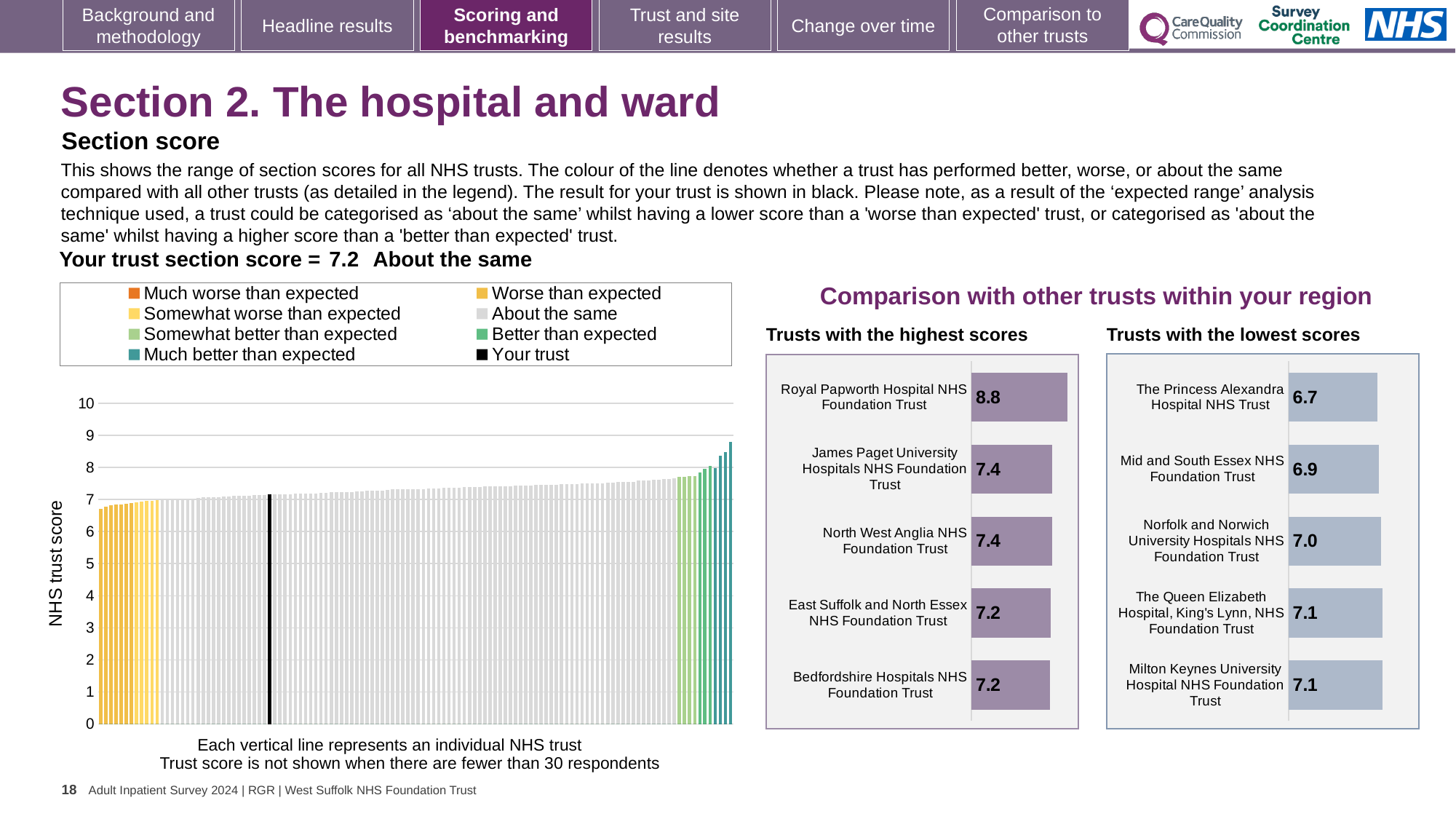
In the 'Trusts with the lowest scores' chart, which has the larger score: Mid and South Essex NHS Foundation Trust or Norfolk and Norwich University Hospitals NHS Foundation Trust? Norfolk and Norwich University Hospitals NHS Foundation Trust In the 'Trusts with the highest scores' chart, which trust has the highest score? Royal Papworth Hospital NHS Foundation Trust In the 'Trusts with the highest scores' chart, what is the score for Royal Papworth Hospital NHS Foundation Trust? 8.8 What kind of chart is the large 'NHS trust score' chart on the left of the slide? bar chart How many trusts are shown in the 'Trusts with the highest scores' chart? 5 How many entries does the legend of the 'NHS trust score' chart on the left list? 8 In the 'Trusts with the highest scores' chart, what is the difference between the scores of Royal Papworth Hospital NHS Foundation Trust and James Paget University Hospitals NHS Foundation Trust? 1.4 In the 'Trusts with the lowest scores' chart, which trust has the lowest score? The Princess Alexandra Hospital NHS Trust In the 'Trusts with the lowest scores' chart, what is the score for The Princess Alexandra Hospital NHS Trust? 6.7 In the 'NHS trust score' chart on the left, do the values rise or fall from left to right? rise In the 'NHS trust score' chart on the left, is the value of the tallest bar greater or less than 8? greater In the 'Trusts with the lowest scores' chart, how much higher is Milton Keynes University Hospital NHS Foundation Trust's score than The Princess Alexandra Hospital NHS Trust's score? 0.4